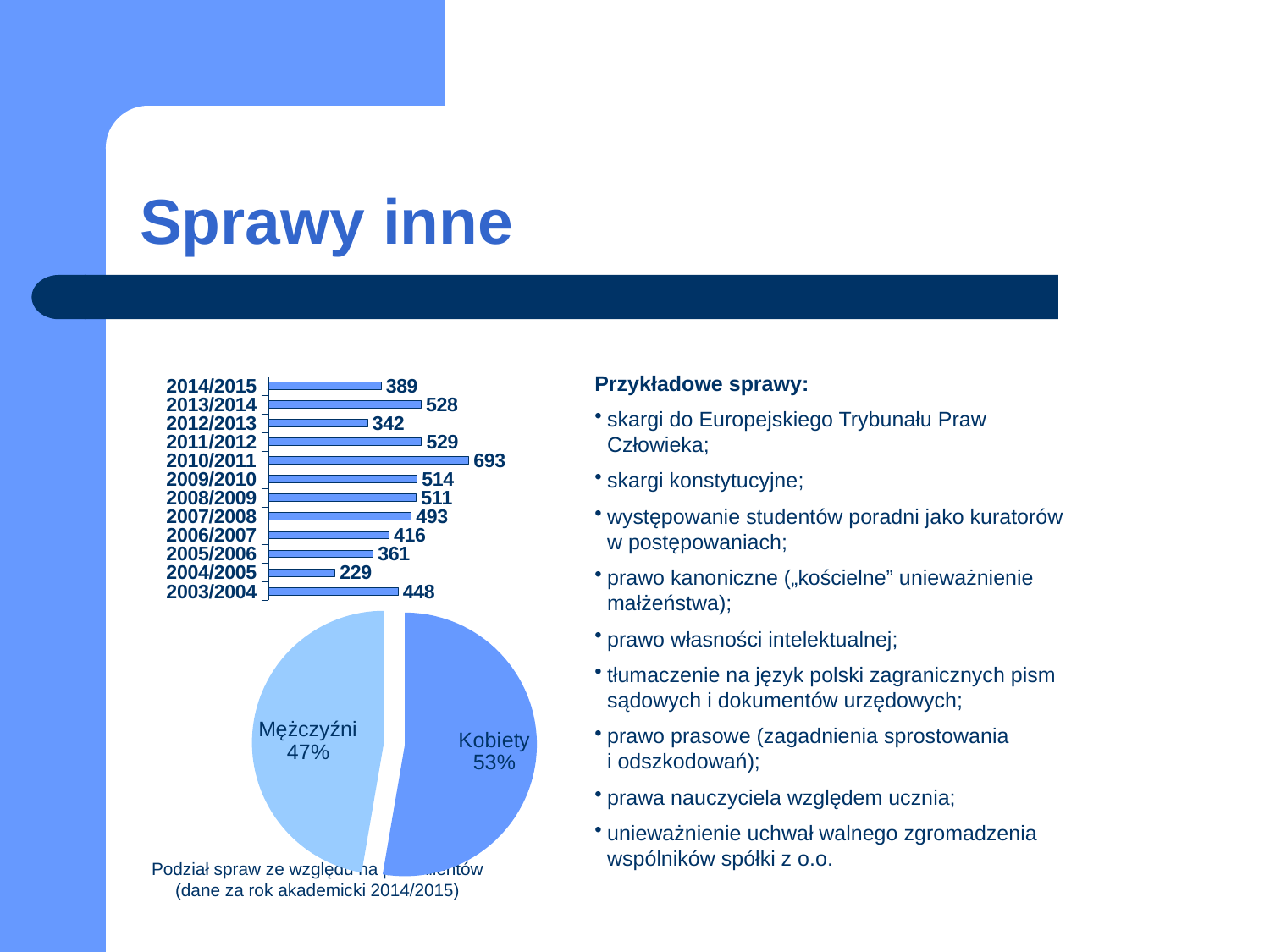
How many academic years are shown in the bar chart at the top left of the slide? 12 In the bar chart at the top left of the slide, what is the value for 2014/2015? 389 In the bar chart at the top left of the slide, what is the value for 2010/2011? 693 In the bar chart at the top left of the slide, what is the value for 2004/2005? 229 What kind of chart is the chart at the top left of the slide showing academic years? bar chart In the bar chart at the top left of the slide, which academic year has the lowest value? 2004/2005 In the pie chart on the left of the slide, which slice is larger, Kobiety or Mężczyźni? Kobiety In the bar chart at the top left of the slide, which is larger, the value for 2003/2004 or the value for 2005/2006? 2003/2004 In the pie chart on the left of the slide, what share is labelled Kobiety? 53% In the bar chart at the top left of the slide, what is the difference between the values for 2013/2014 and 2012/2013? 186 How many slices does the pie chart on the left of the slide have? 2 In the bar chart at the top left of the slide, which academic year has the highest value? 2010/2011